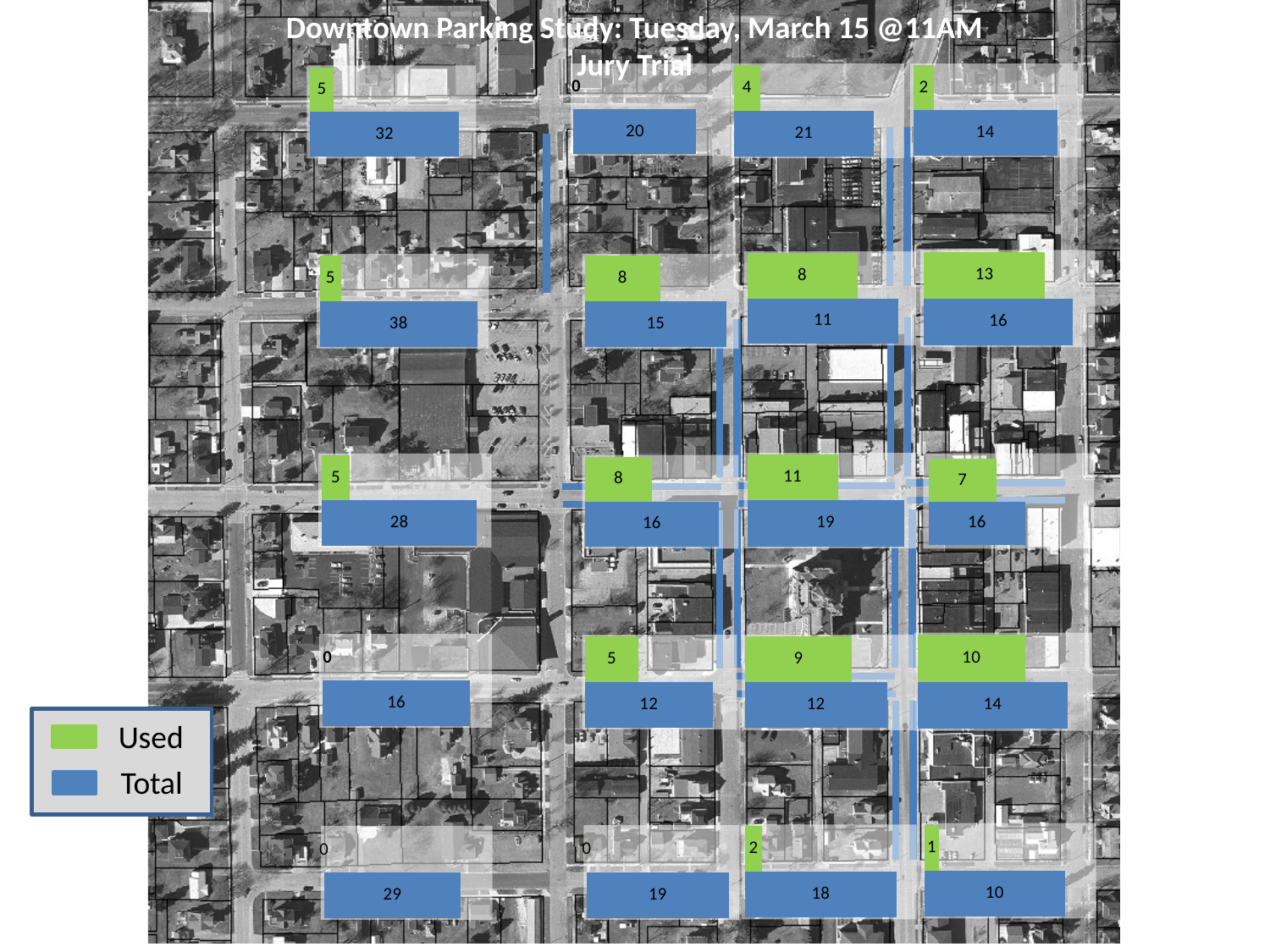
For the block chart in the top-left corner of the map, what is the Total value? 32 What kind of chart is used to show the parking counts on each block? Bar chart What are the two series named in the legend? Used and Total For the block chart in the bottom-left corner of the map, what is the Used value? 0 Across all the block charts on the map, what is the largest Used value shown? 13 Across all the block charts on the map, what is the largest Total value shown? 38 How many series does the legend list? 2 In the block chart in the fourth row, third column (Total 12), is the Used value larger or smaller than the Total value? Smaller What colour represents the Used series in the legend? Green For the block chart in the top-left corner of the map, what is the Used value? 5 For the block chart in the bottom-right corner of the map, what is the Total value? 10 For the block chart in the second row, rightmost column (Used 13), what is the difference between Total and Used? 3